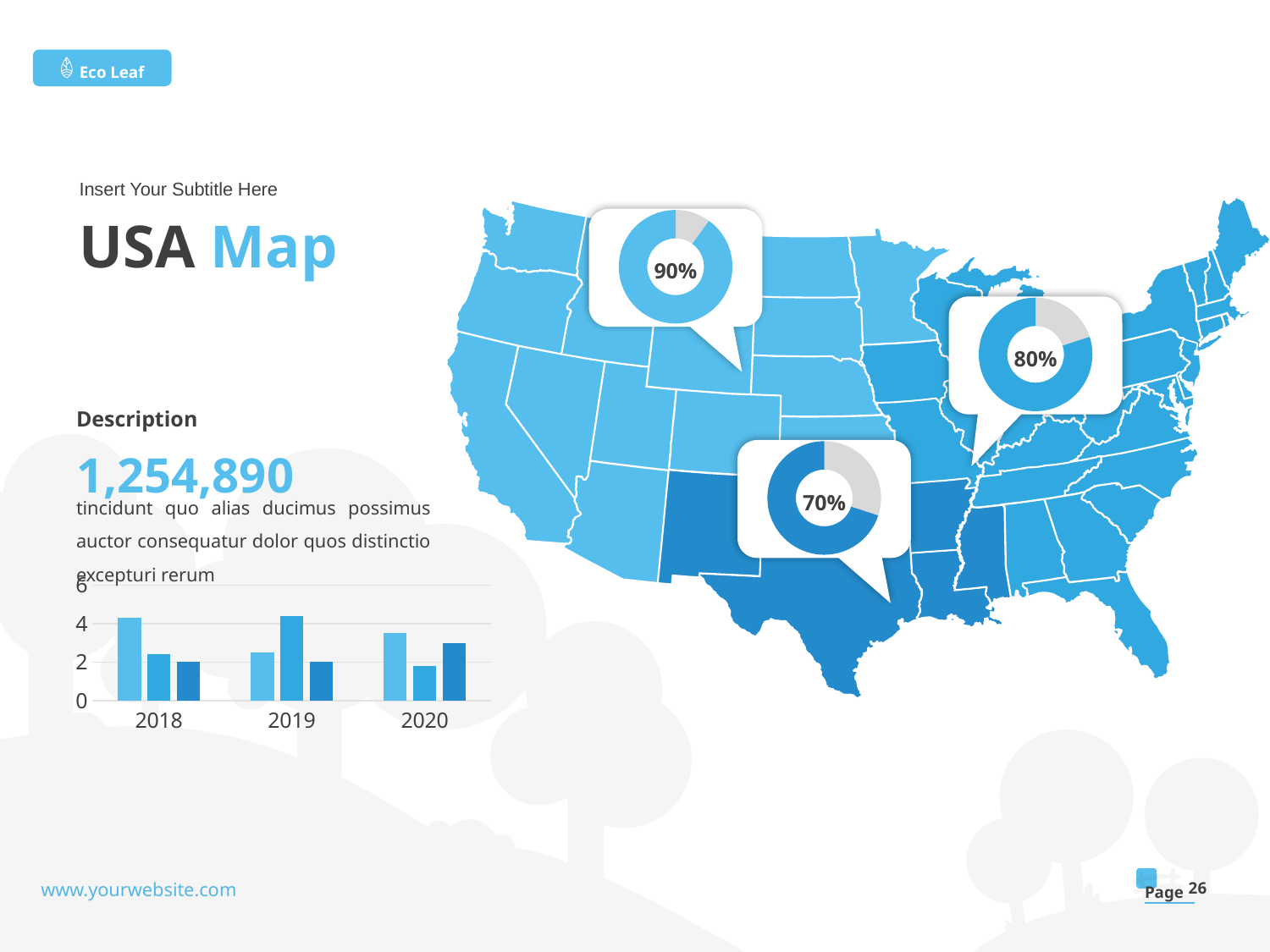
What percentage is shown in the donut chart over the northeastern part of the USA map? 80% Which years are shown on the x axis of the bar chart at the bottom left? 2018, 2019, 2020 In the bar chart at the bottom left, is the value of the first (lightest) bar for 2019 greater or less than 4? less What is the difference between the highest and lowest percentages shown in the three donut charts on the USA map? 20% In the bar chart at the bottom left, is the value of the first (lightest) bar for 2020 greater or less than 2? greater What percentage is shown in the donut chart over the southern part of the USA map? 70% What kind of chart is shown at the bottom left of the slide? bar chart How many years are shown on the x axis of the bar chart at the bottom left? 3 In the bar chart at the bottom left, is the value of the first (lightest) bar for 2018 greater or less than 2? greater In the bar chart at the bottom left, which bar is taller for 2018: the first (lightest) bar or the third (darkest) bar? the first (lightest) bar In the bar chart at the bottom left, which bar is taller for 2019: the first (lightest) bar or the middle bar? the middle bar What percentage is shown in the donut chart over the northwestern part of the USA map? 90%